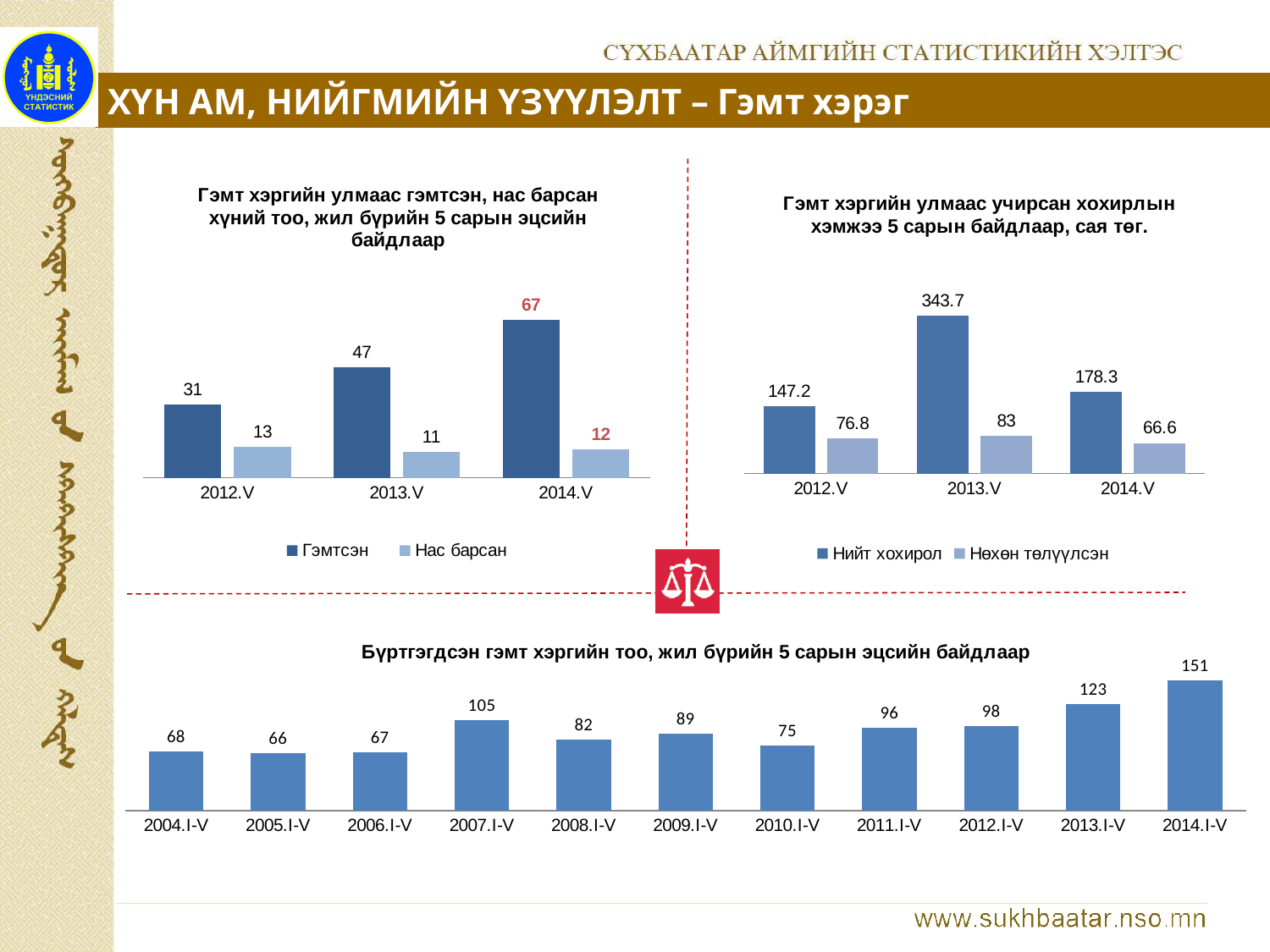
In the top-left chart, what is the value of Нас барсан for 2013.V? 11 In the bottom chart, how many categories are shown on the x axis? 11 In the top-right chart, which year has the highest Нийт хохирол? 2013.V In the top-left chart, how many series does the legend list? 2 In the top-left chart, what is the value of Гэмтсэн for 2014.V? 67 In the top-right chart, what is the value of Нийт хохирол for 2013.V? 343.7 In the top-right chart, what is the difference between Нийт хохирол and Нөхөн төлүүлсэн for 2012.V? 70.4 In the bottom chart, which year has the lowest value? 2005.I-V What kind of chart is the bottom chart? Bar chart In the top-left chart, what is the difference between Гэмтсэн and Нас барсан for 2012.V? 18 In the bottom chart, what is the value for 2007.I-V? 105 In the top-right chart, what is the value of Нөхөн төлүүлсэн for 2014.V? 66.6